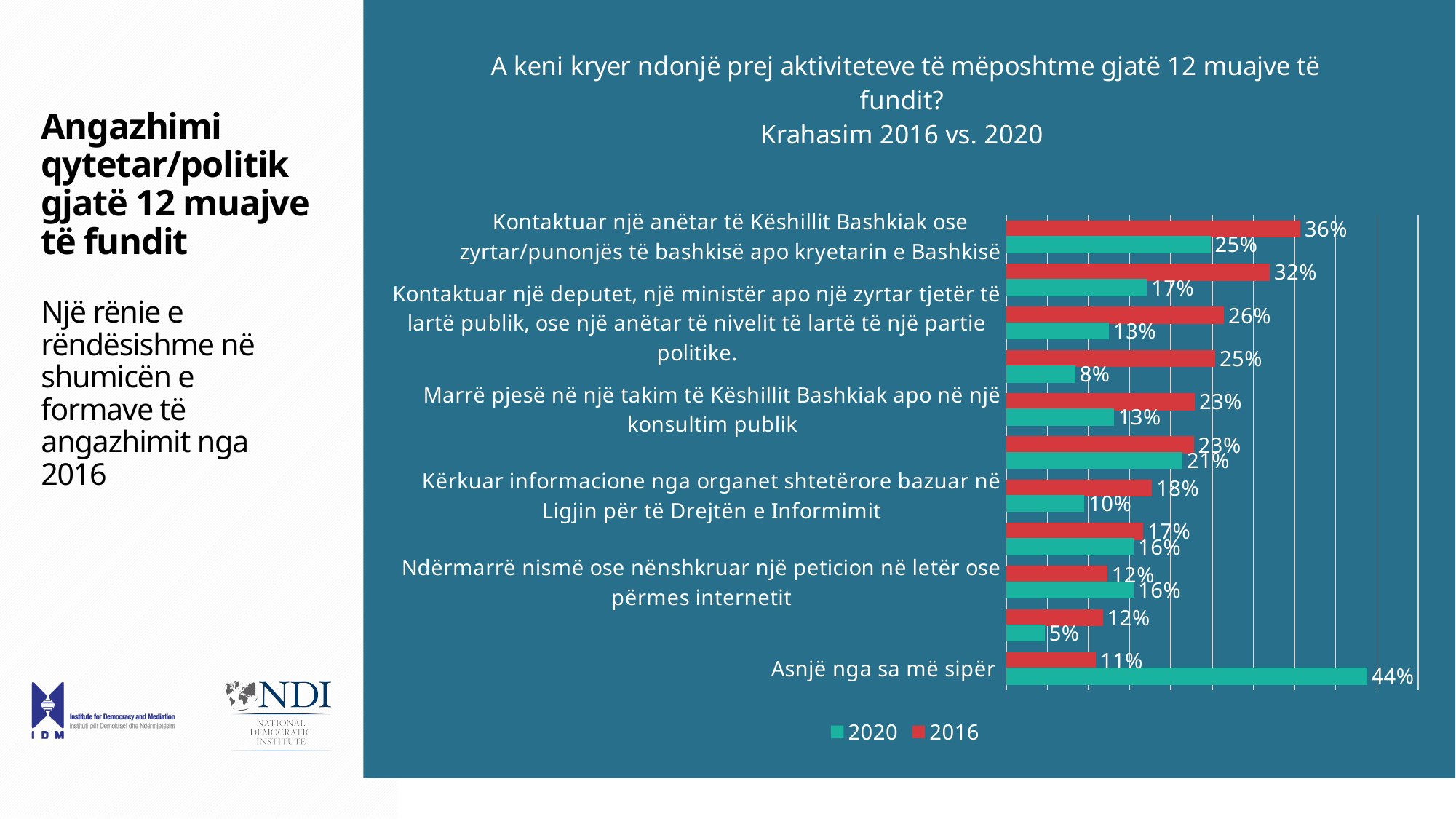
Which two series are listed in the legend? 2020 and 2016 What colour are the 2016 bars? Red What is the difference between the 2020 and 2016 values for "Asnjë nga sa më sipër"? 33% What is the 2020 value for "Asnjë nga sa më sipër"? 44% What is the 2016 value for "Asnjë nga sa më sipër"? 11% How many series does the legend list? 2 What is the 2016 value for "Kontaktuar një anëtar të Këshillit Bashkiak ose zyrtar/punonjës të bashkisë apo kryetarin e Bashkisë"? 36% For "Asnjë nga sa më sipër", which is larger, the 2020 value or the 2016 value? 2020 Which category has the highest 2016 value? Kontaktuar një anëtar të Këshillit Bashkiak ose zyrtar/punonjës të bashkisë apo kryetarin e Bashkisë Which category has the highest 2020 value? Asnjë nga sa më sipër What kind of chart is shown on the slide? Bar chart What is the 2020 value for "Kontaktuar një anëtar të Këshillit Bashkiak ose zyrtar/punonjës të bashkisë apo kryetarin e Bashkisë"? 25%